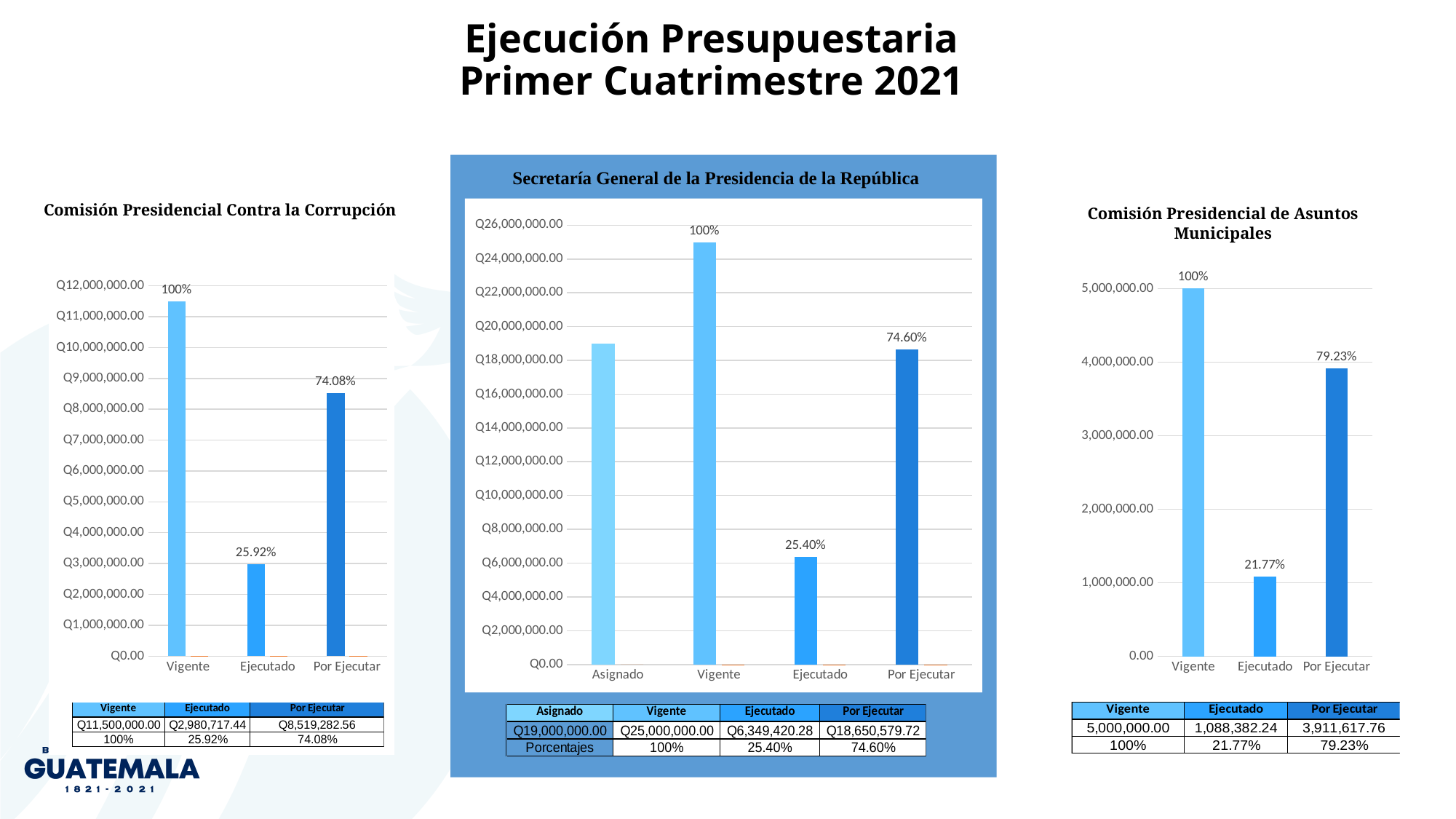
In the 'Comisión Presidencial de Asuntos Municipales' chart, which category has the lowest value? Ejecutado In the 'Secretaría General de la Presidencia de la República' chart, what percentage label is shown on the Por Ejecutar bar? 74.60% In the 'Secretaría General de la Presidencia de la República' chart, what is the difference between the Vigente and Ejecutado values? Q18,650,579.72 In the 'Comisión Presidencial de Asuntos Municipales' chart, what is the value for Ejecutado? 1,088,382.24 In the 'Secretaría General de la Presidencia de la República' chart, how many bars are plotted? 4 In the 'Secretaría General de la Presidencia de la República' chart, which category has the highest value? Vigente In the 'Secretaría General de la Presidencia de la República' chart, what is the value for Asignado? Q19,000,000.00 In the 'Secretaría General de la Presidencia de la República' chart, which is larger, Asignado or Por Ejecutar? Asignado In the 'Comisión Presidencial Contra la Corrupción' chart, what percentage label is shown on the Ejecutado bar? 25.92% What type of chart is the 'Comisión Presidencial de Asuntos Municipales' chart? Bar chart In the 'Comisión Presidencial Contra la Corrupción' chart, is the value for Ejecutado greater or less than Q4,000,000.00? less In the 'Comisión Presidencial Contra la Corrupción' chart, what is the value for Por Ejecutar? Q8,519,282.56